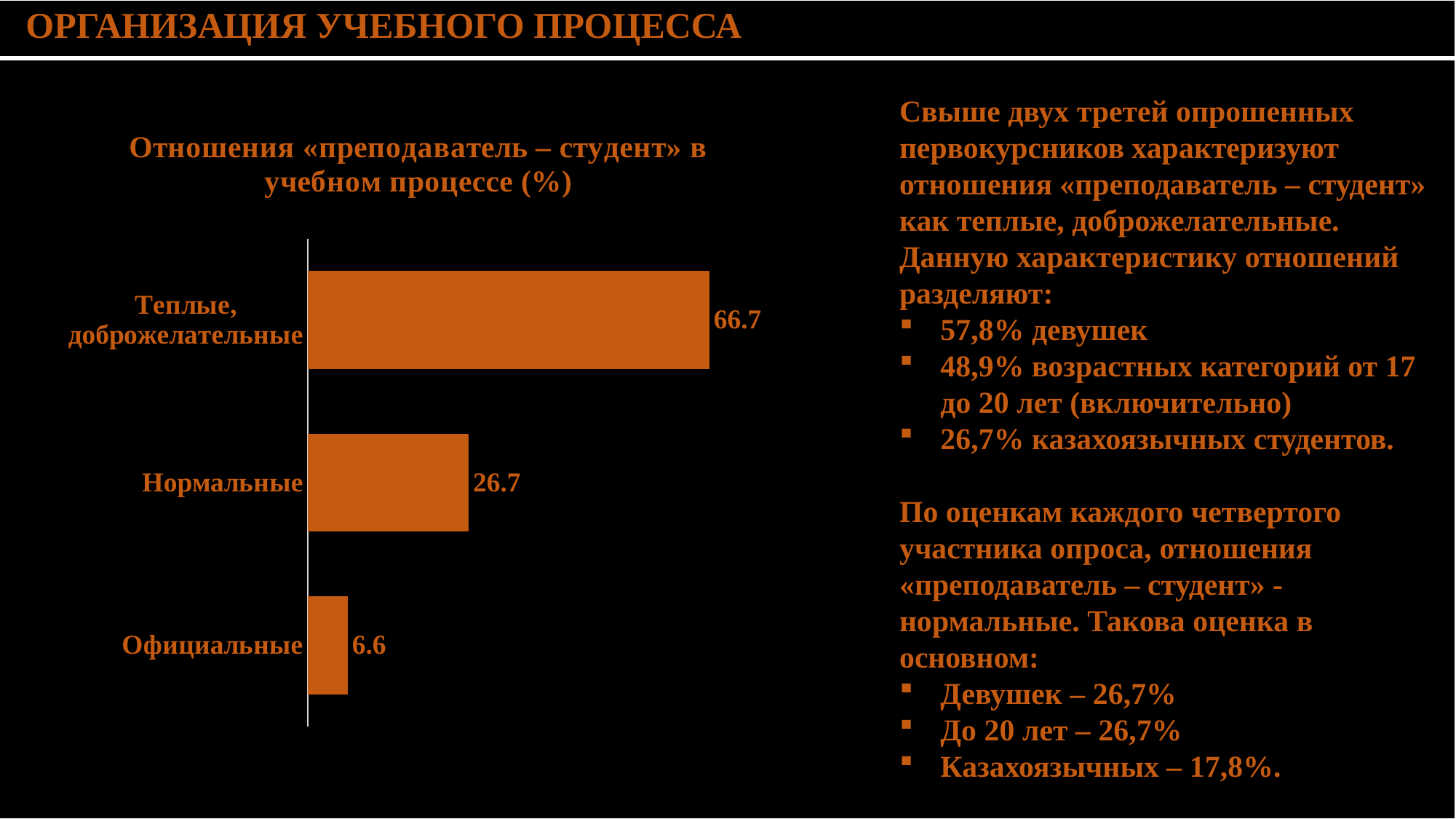
What kind of chart is shown on the slide? Bar chart What is the value for «Теплые, доброжелательные» in the chart? 66.7 What is the value for «Нормальные» in the chart? 26.7 What is the value for «Официальные» in the chart? 6.6 What is the difference between the values for «Теплые, доброжелательные» and «Нормальные»? 40 Which category has the highest value in the chart? Теплые, доброжелательные How many categories are shown in the chart? 3 What is the difference between the values for «Нормальные» and «Официальные»? 20.1 Which category has the lowest value in the chart? Официальные What is the title of the chart? Отношения «преподаватель – студент» в учебном процессе (%) Which is larger: the value for «Нормальные» or the value for «Официальные»? Нормальные What colour are the bars in the chart? Orange